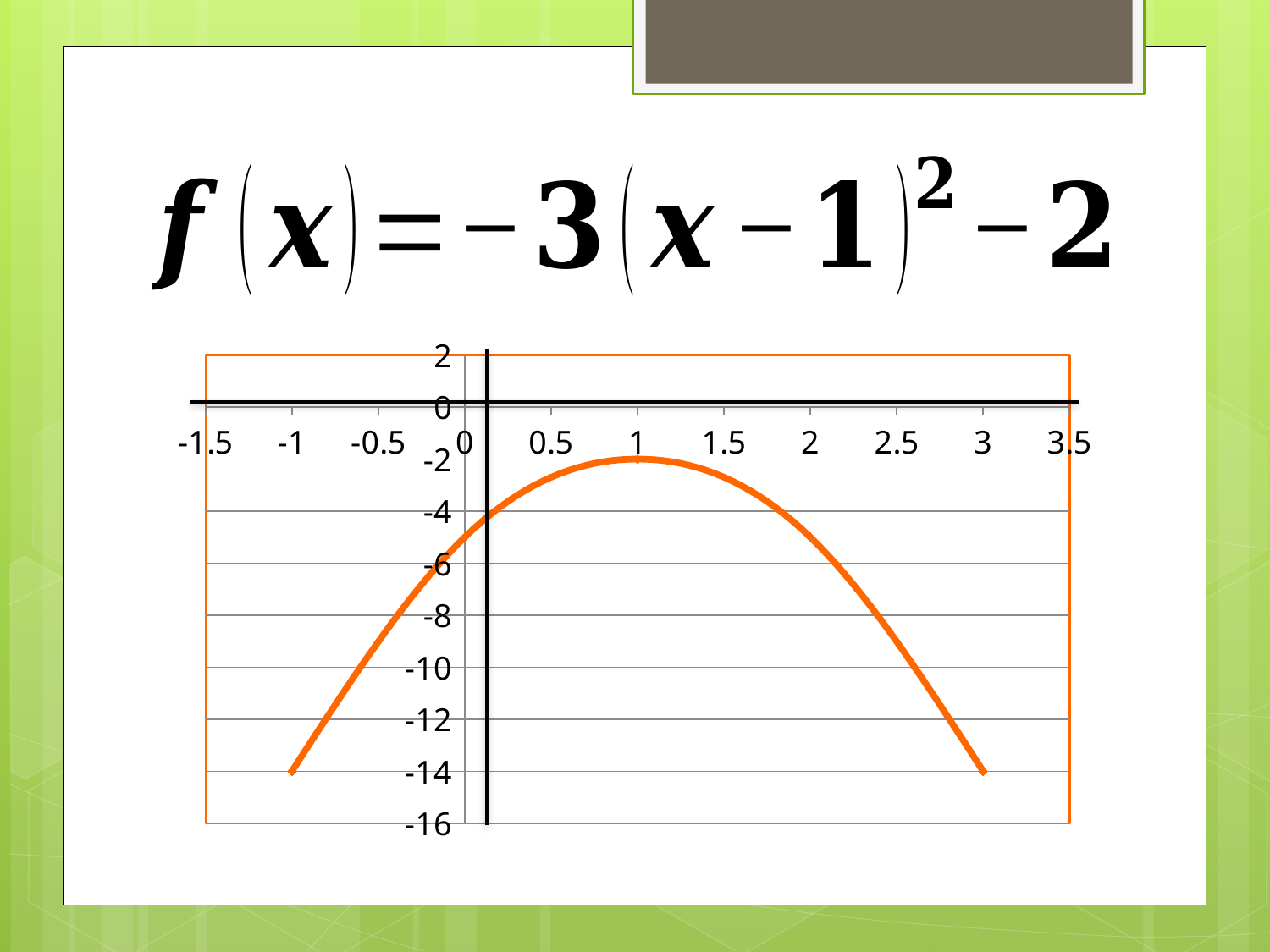
What kind of chart is shown on the slide? line chart Does the curve rise or fall as x increases from -1 to 1? rise What is the lowest value shown on the vertical axis? -16 What is the value of the curve at x = 1? -2 Is the value of the curve at x = 0.5 greater or less than -4? greater What is the value of the curve at x = -1? -14 At which x value does the plotted curve reach its highest point? 1 Does the curve rise or fall as x increases from 1 to 3? fall Which is larger, the value of the curve at x = 0 or at x = 1? x = 1 Is the value of the curve at x = 0 greater or less than -4? less What is the value of the curve at x = 3? -14 What is the difference between the value of the curve at x = 1 and at x = -1? 12